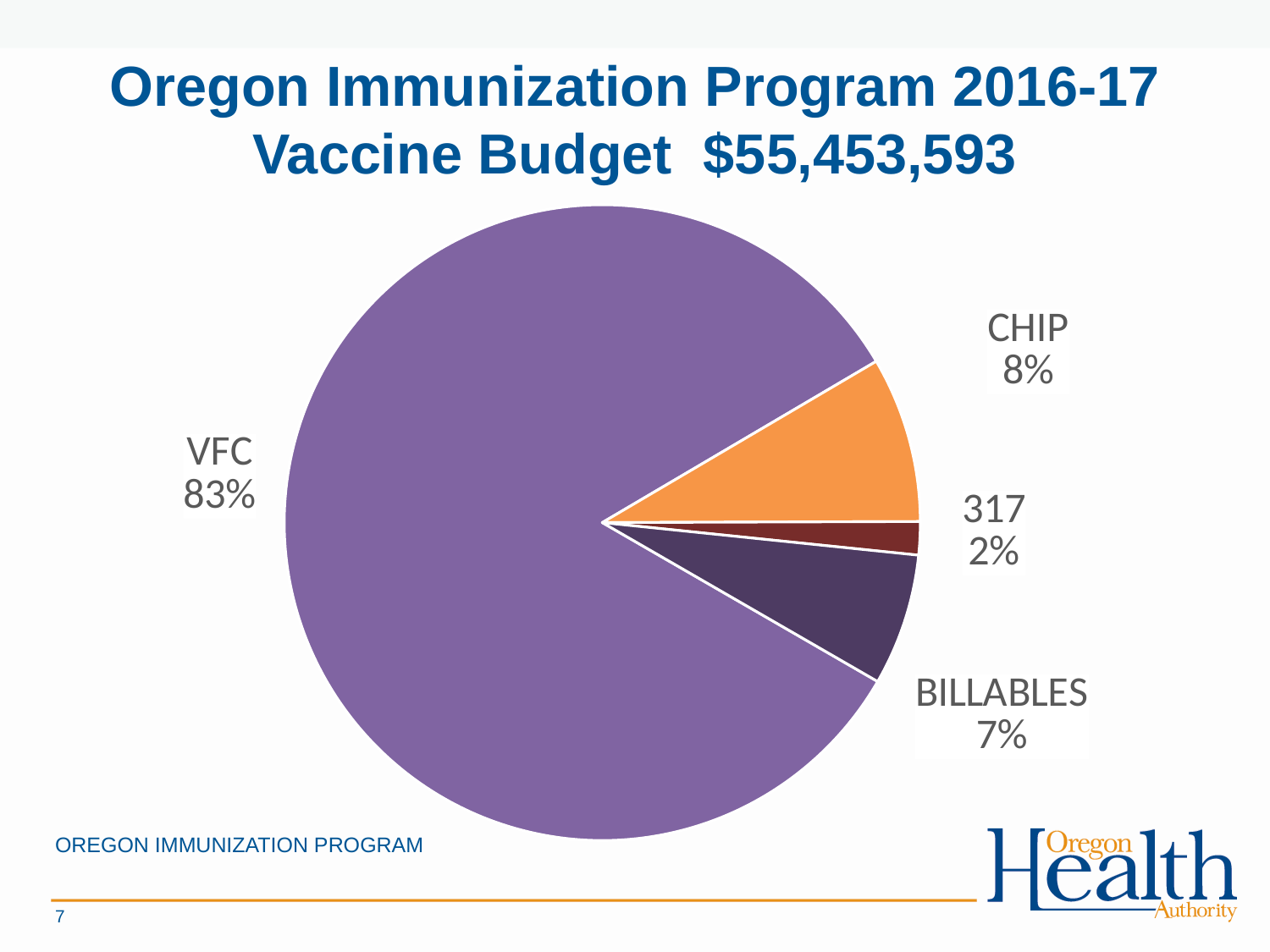
What colour is the VFC slice? purple What share of the vaccine budget does BILLABLES account for? 7% How many slices does the pie chart have? 4 What total vaccine budget is stated in the chart title? $55,453,593 What kind of chart is shown on the slide? pie chart What share of the vaccine budget does VFC account for? 83% What is the difference in percentage points between the VFC share and the CHIP share? 75 percentage points What share of the vaccine budget does 317 account for? 2% Which category has the largest slice of the pie? VFC Which category has the smallest slice of the pie? 317 Which is larger, the CHIP share or the BILLABLES share? CHIP